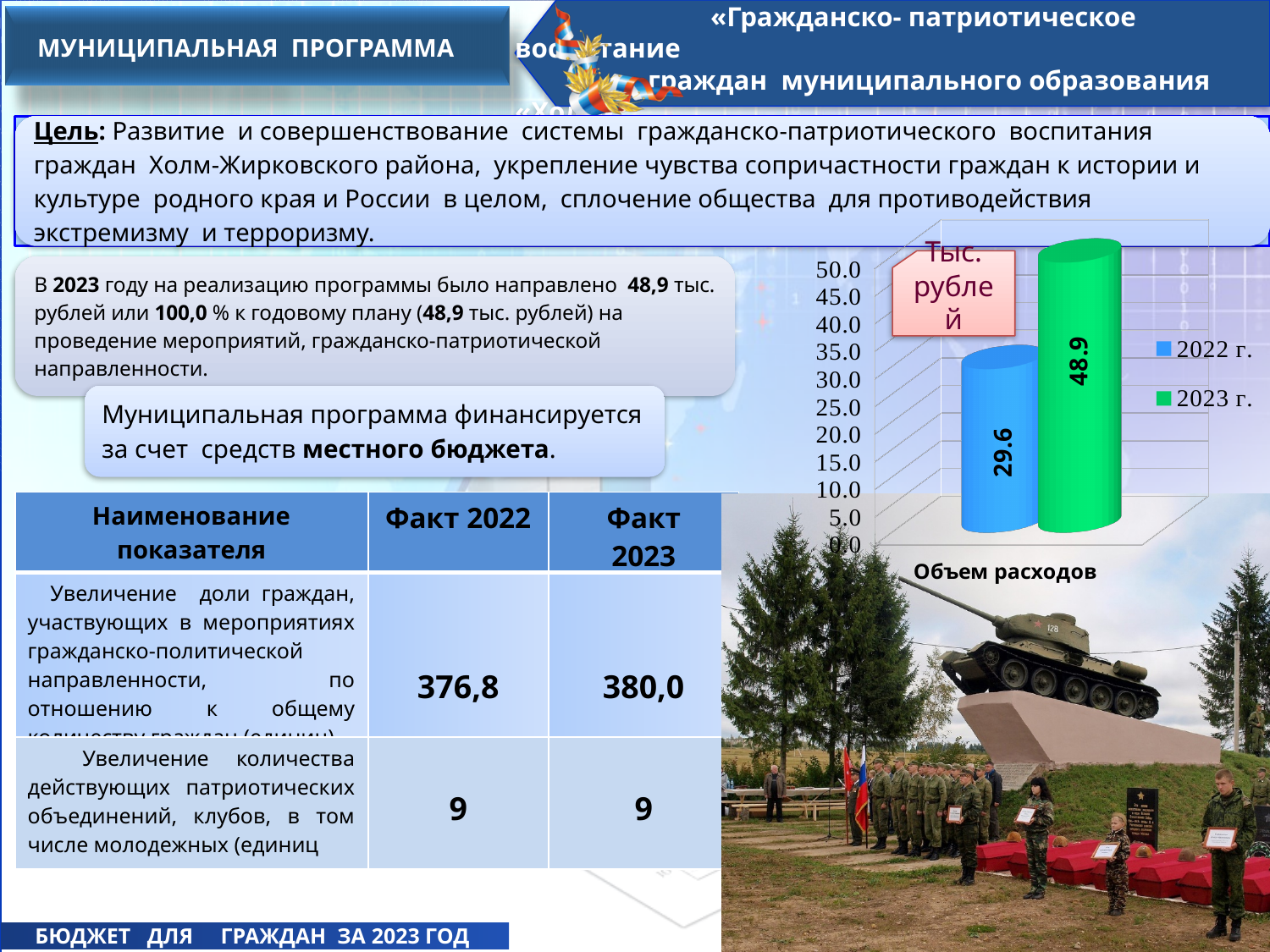
What is the difference between the 2023 г. and 2022 г. values in the chart? 19,3 What kind of chart is shown on the slide? bar chart Which year has the highest value in the chart? 2023 г. What is the value for 2023 г. in the chart? 48,9 Is the value for 2023 г. greater or less than 45.0? greater Is the value for 2022 г. greater or less than 30.0? less How many series does the chart legend list? 2 Which year has the lowest value in the chart? 2022 г. What is the value for 2022 г. in the chart? 29,6 Do the values in the chart rise or fall from 2022 г. to 2023 г.? rise Which year has the higher value in the chart, 2022 г. or 2023 г.? 2023 г. What is the title shown under the chart? Объем расходов